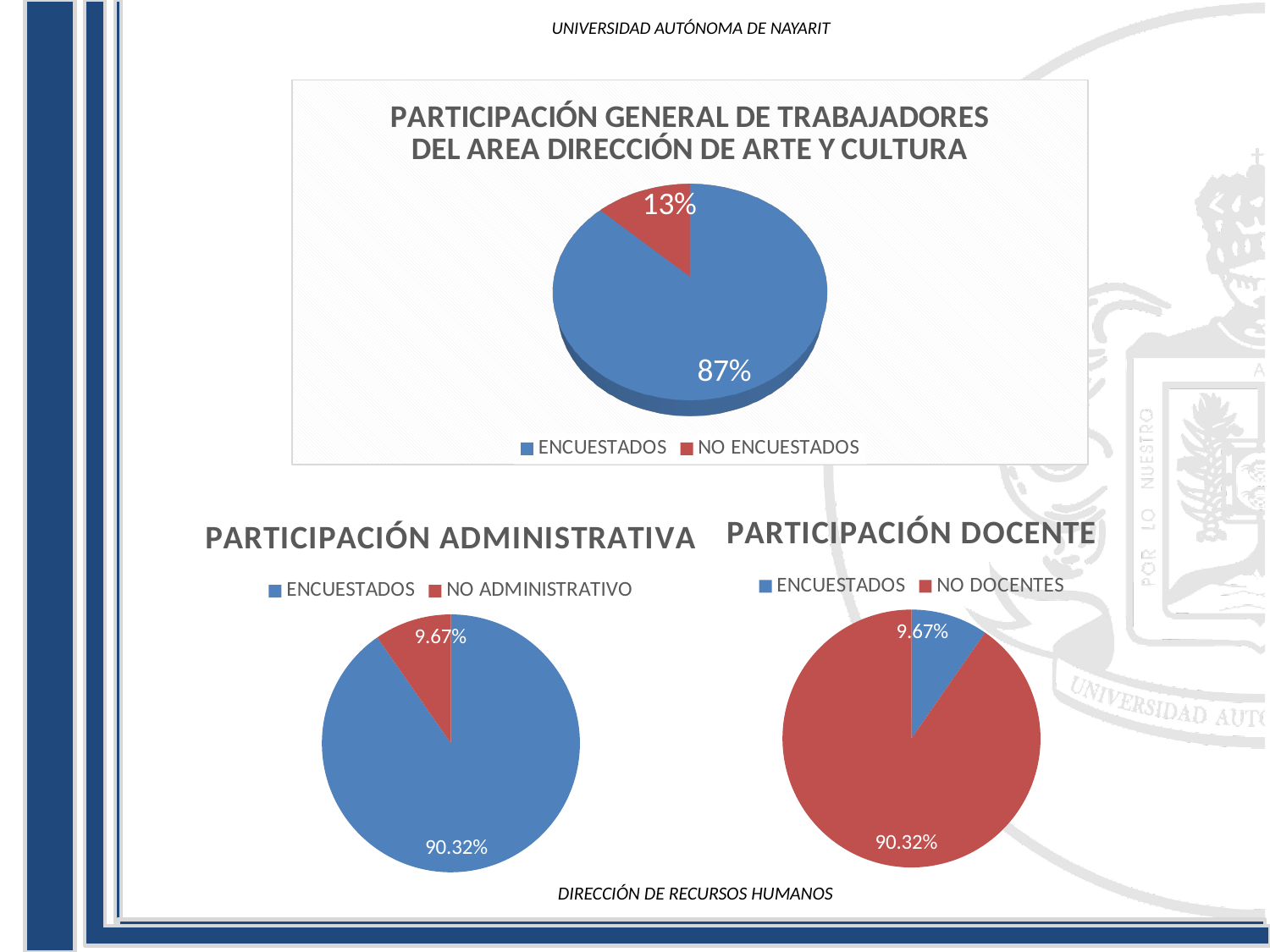
In the chart titled PARTICIPACIÓN DOCENTE, what share of the pie is ENCUESTADOS? 9.67% In the chart titled PARTICIPACIÓN ADMINISTRATIVA, what share of the pie is NO ADMINISTRATIVO? 9.67% In the chart titled PARTICIPACIÓN DOCENTE, which is larger, ENCUESTADOS or NO DOCENTES? NO DOCENTES In the chart titled PARTICIPACIÓN ADMINISTRATIVA, which slice is the smallest? NO ADMINISTRATIVO In the chart titled PARTICIPACIÓN GENERAL DE TRABAJADORES DEL AREA DIRECCIÓN DE ARTE Y CULTURA, which slice is the largest? ENCUESTADOS In the chart titled PARTICIPACIÓN GENERAL DE TRABAJADORES DEL AREA DIRECCIÓN DE ARTE Y CULTURA, what share of the pie is ENCUESTADOS? 87% In the chart titled PARTICIPACIÓN GENERAL DE TRABAJADORES DEL AREA DIRECCIÓN DE ARTE Y CULTURA, what is the difference between the ENCUESTADOS and NO ENCUESTADOS shares? 74% What kind of chart is the chart titled PARTICIPACIÓN GENERAL DE TRABAJADORES DEL AREA DIRECCIÓN DE ARTE Y CULTURA? Pie chart How many entries does the legend of the chart titled PARTICIPACIÓN DOCENTE list? 2